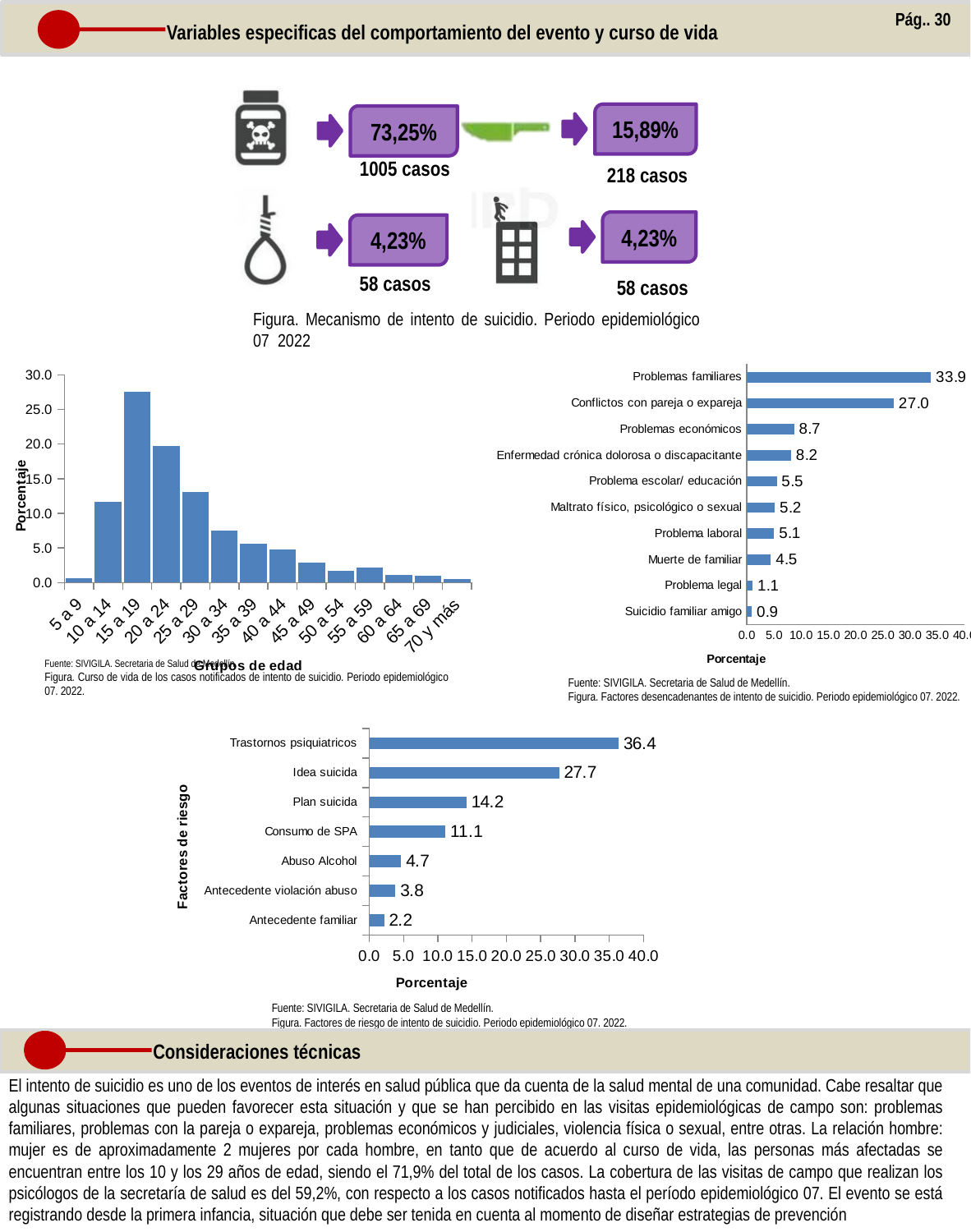
In the 'Factores desencadenantes' chart on the right, which is larger: Problema escolar/ educación or Muerte de familiar? Problema escolar/ educación In the 'Factores desencadenantes' chart on the right, what is the difference between Problemas familiares and Conflictos con pareja o expareja? 6.9 In the 'Factores de riesgo' chart at the bottom, what is the difference between Trastornos psiquiatricos and Idea suicida? 8.7 In the 'Factores desencadenantes' chart on the right, which category has the lowest value? Suicidio familiar amigo In the 'Grupos de edad' chart on the left, which age group has the highest value? 15 a 19 In the 'Factores desencadenantes' chart on the right, how many categories are shown? 10 In the 'Factores desencadenantes' chart on the right, what is the value for Problemas familiares? 33.9 In the 'Factores de riesgo' chart at the bottom, how many categories are shown? 7 In the 'Grupos de edad' chart on the left, is the value for 15 a 19 greater or less than 25.0? greater In the 'Factores de riesgo' chart at the bottom, what is the value for Consumo de SPA? 11.1 What kind of chart is the 'Grupos de edad' chart on the left? Bar chart In the 'Factores de riesgo' chart at the bottom, which category has the highest value? Trastornos psiquiatricos